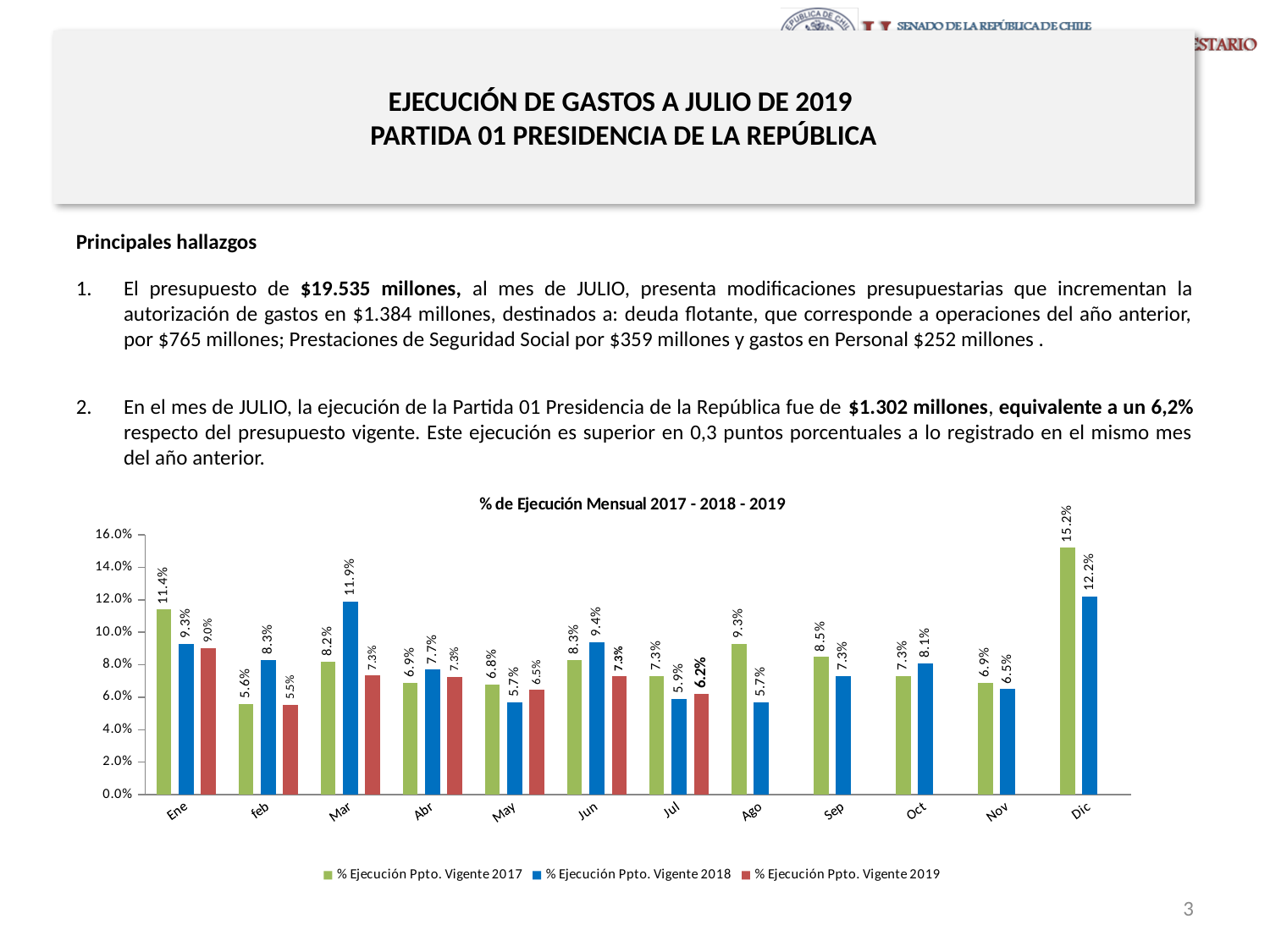
What is the title of the chart? % de Ejecución Mensual 2017 - 2018 - 2019 What is the difference between the 2017 and 2018 values in Dic? 3.0% In Ago, which is larger: the 2017 value or the 2018 value? 2017 Which month has the lowest value for % Ejecución Ppto. Vigente 2019? feb What kind of chart is shown on the slide? Bar chart What is the value for % Ejecución Ppto. Vigente 2017 in Ene? 11.4% What is the value for % Ejecución Ppto. Vigente 2019 in Jul? 6.2% Which month has the highest value for % Ejecución Ppto. Vigente 2017? Dic How many months have a value plotted for % Ejecución Ppto. Vigente 2019? 7 How many series does the legend list? 3 What is the value for % Ejecución Ppto. Vigente 2018 in Mar? 11.9% What colour represents % Ejecución Ppto. Vigente 2018 in the chart? Blue